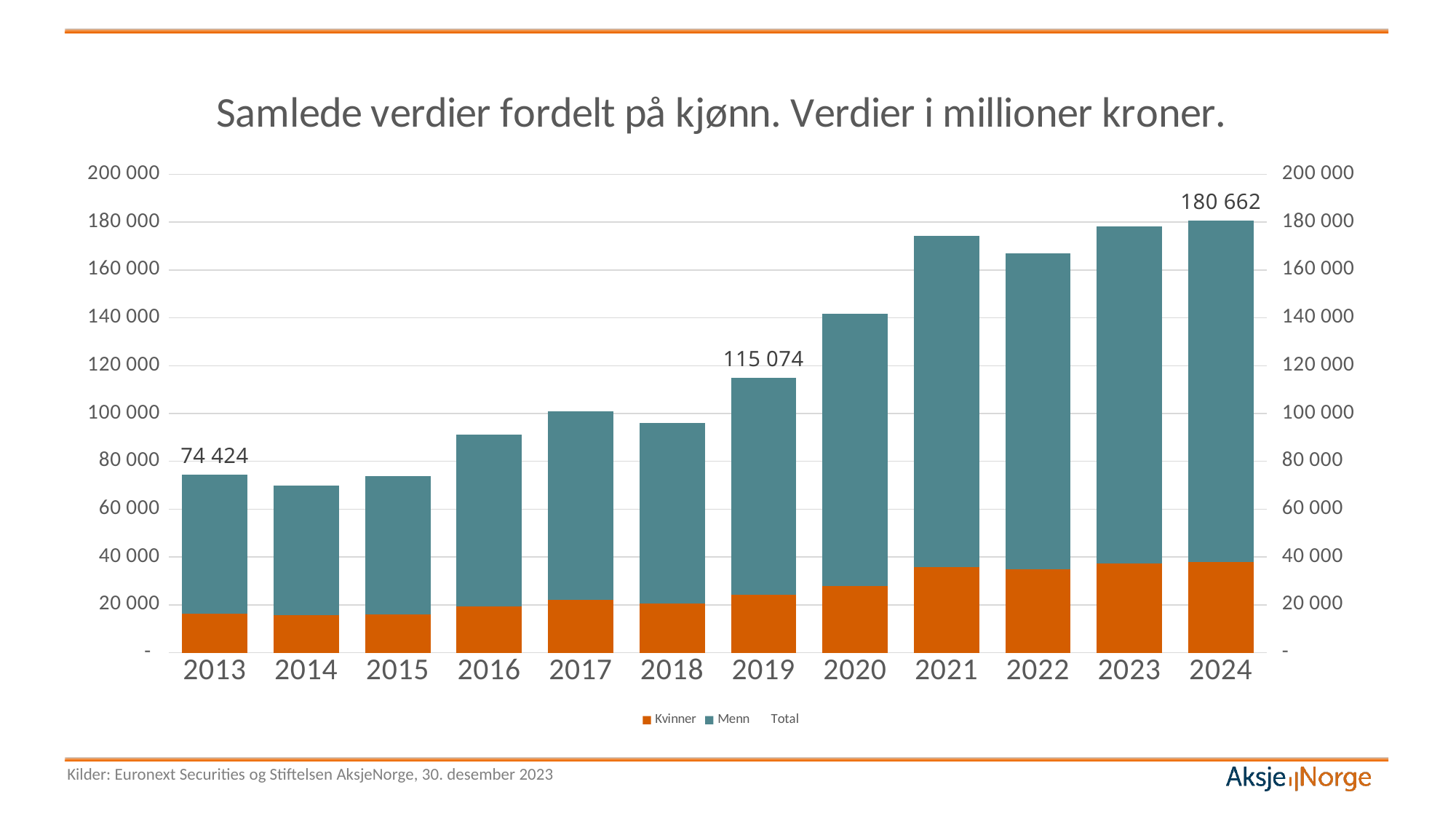
Is the total value for 2018 greater or less than 100 000? less Which year has the lowest total bar? 2014 What is the total value shown for 2013? 74 424 How many years are shown on the x axis? 12 Which year has the highest total bar? 2024 What is the difference between the total for 2024 and the total for 2013? 106 238 What is the total value shown for 2019? 115 074 What is the difference between the total for 2019 and the total for 2013? 40 650 What is the total value shown for 2024? 180 662 Is the Kvinner value for 2024 greater or less than 20 000? greater How many entries does the legend list? 3 Which year has a higher total bar, 2021 or 2022? 2021